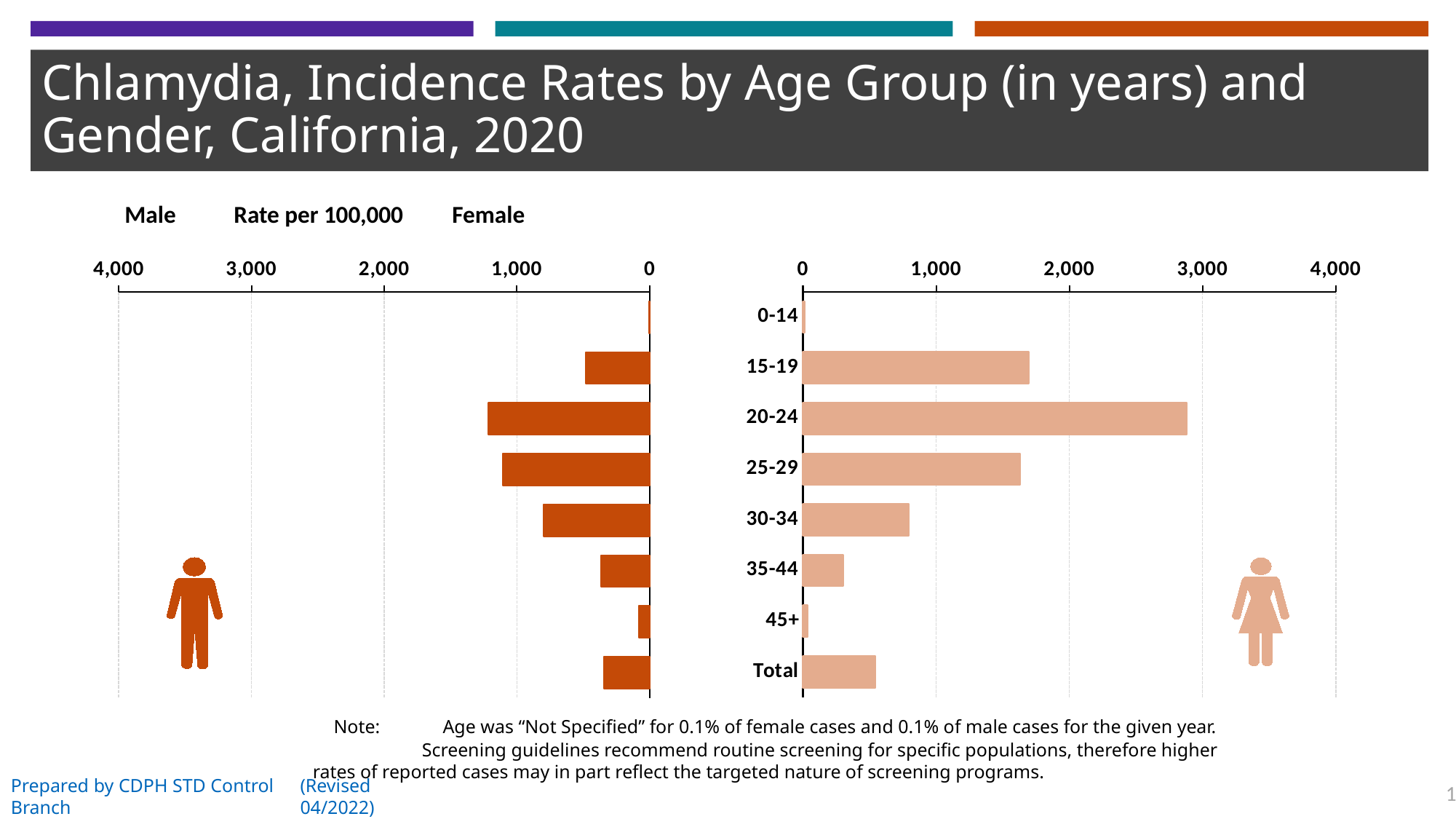
Is the male rate for the 15-19 age group greater or less than 1,000? less Is the female rate for the 15-19 age group greater or less than 1,000? greater Do the female rates rise or fall across the age groups from 20-24 through 45+? Fall Is the female Total rate greater or less than 1,000? less What unit are the rates on the chart expressed in? Rate per 100,000 Which age group has the highest male chlamydia incidence rate? 20-24 Which age group has the highest female chlamydia incidence rate? 20-24 For the 20-24 age group, is the male or the female rate larger? Female How many age-group categories (including Total) are listed on the chart? 8 What kind of chart is shown on the slide? Bar chart